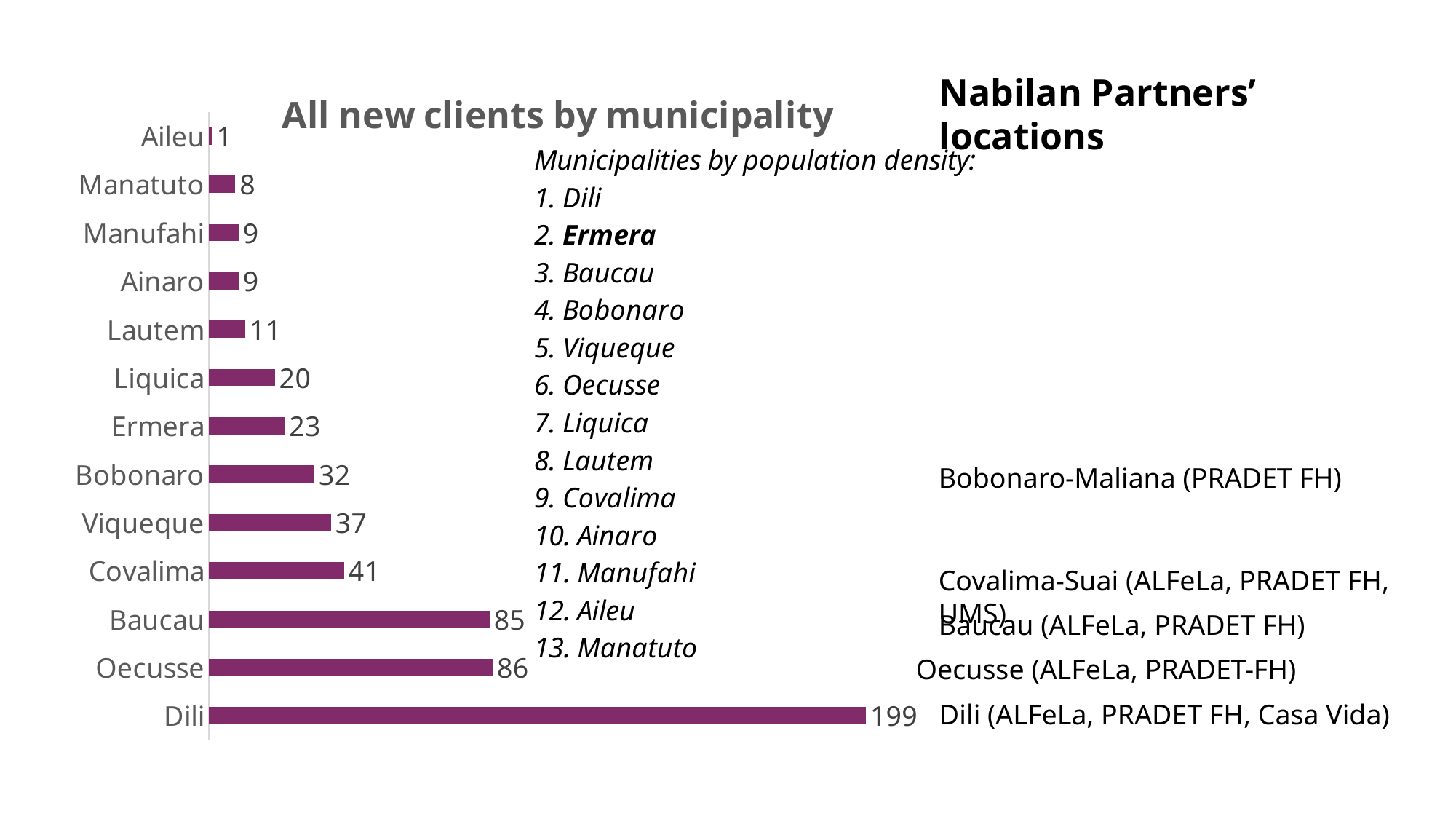
Which municipality has the lowest number of new clients? Aileu What is the value for Dili in the 'All new clients by municipality' chart? 199 How many new clients does the chart show for Bobonaro? 32 What type of chart is shown on the slide? Bar chart Which has more new clients, Viqueque or Ermera? Viqueque What is the title of the chart? All new clients by municipality How many municipalities are shown in the chart? 13 Which municipality has the highest number of new clients? Dili What is the difference between the values for Oecusse and Baucau? 1 What is the difference between the values for Dili and Covalima? 158 What colour are the bars in the chart? Purple What is the value for Liquica? 20